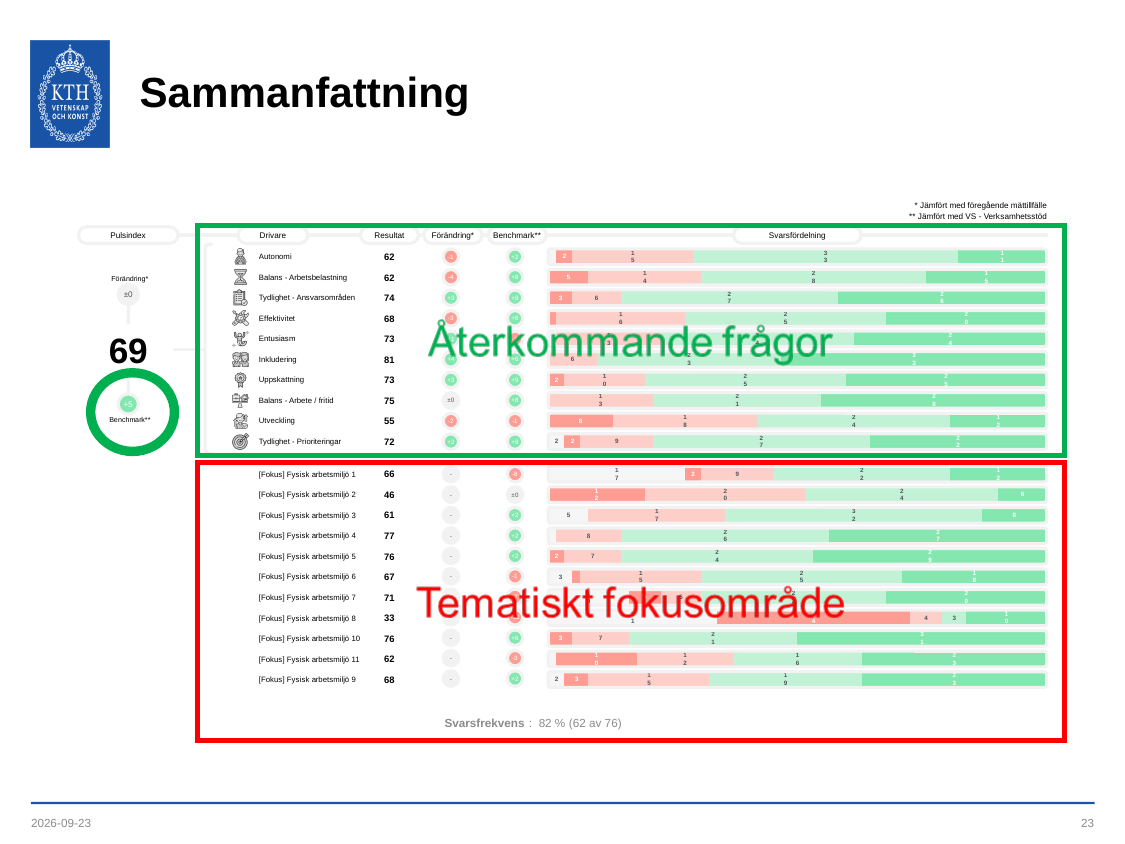
Which has a higher Resultat, Tydlighet - Ansvarsområden or Effektivitet? Tydlighet - Ansvarsområden How many drivers are listed in the Återkommande frågor section? 10 How many [Fokus] Fysisk arbetsmiljö items are listed in the Tematiskt fokusområde section? 11 What is the Pulsindex value shown on the left of the slide? 69 What is the Resultat value for [Fokus] Fysisk arbetsmiljö 8? 33 Which item in the Tematiskt fokusområde section has the lowest Resultat? [Fokus] Fysisk arbetsmiljö 8 Which item in the Tematiskt fokusområde section has the highest Resultat? [Fokus] Fysisk arbetsmiljö 4 Which driver in the Återkommande frågor section has the lowest Resultat? Utveckling What is the Resultat value for Inkludering in the Återkommande frågor section? 81 Which driver in the Återkommande frågor section has the highest Resultat? Inkludering What is the difference between the Resultat for Inkludering and the Resultat for Utveckling? 26 What is the Resultat value for Utveckling? 55